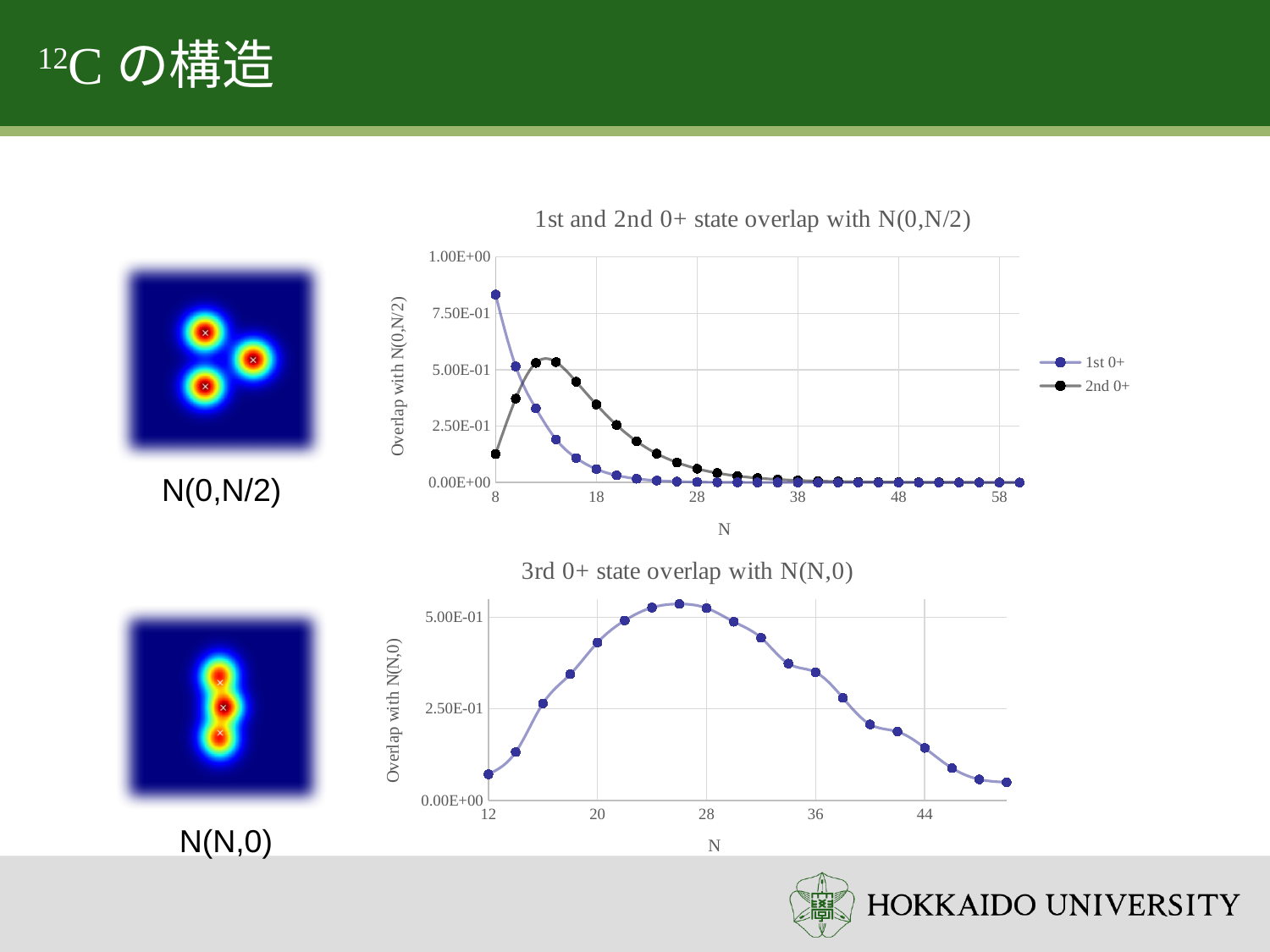
In the top chart, is the value of the 1st 0+ series at N=8 greater or less than 7.50E-01? greater What are the two legend entries in the top chart? 1st 0+ and 2nd 0+ In the bottom chart, does the value rise or fall as N increases from 36 to 44? fall In the top chart, is the value of the 2nd 0+ series at N=8 greater or less than 2.50E-01? less What is the title of the bottom chart? 3rd 0+ state overlap with N(N,0) How many series does the legend of the top chart list? 2 In the bottom chart, is the peak value of the series greater or less than 5.00E-01? greater What kind of chart is the top chart titled "1st and 2nd 0+ state overlap with N(0,N/2)"? line chart In the top chart, which series has the larger value at N=8, 1st 0+ or 2nd 0+? 1st 0+ In the top chart, which series has the larger value at N=18, 1st 0+ or 2nd 0+? 2nd 0+ In the top chart, does the 1st 0+ series rise or fall as N increases from 8? fall